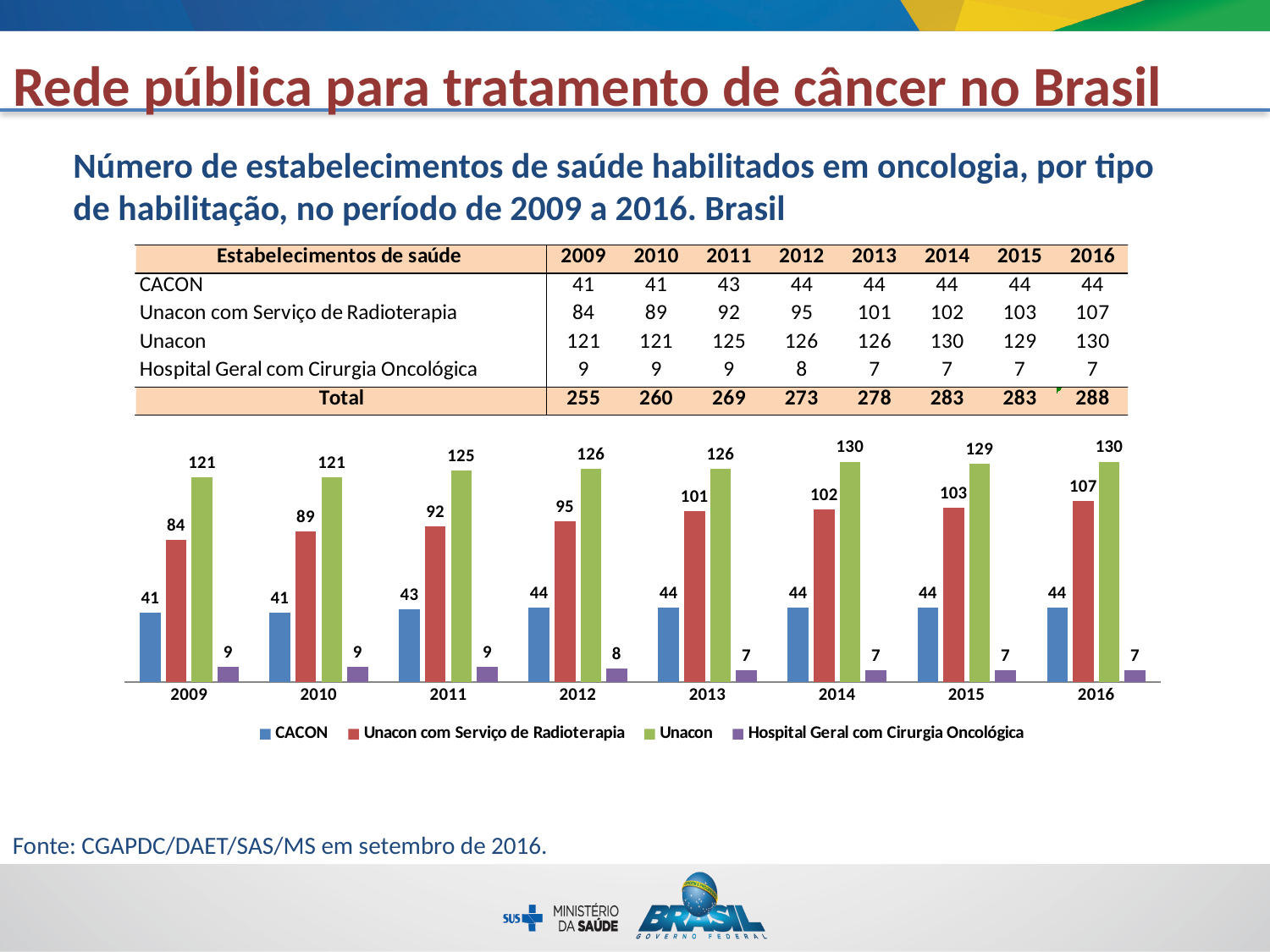
Which is larger: Unacon com Serviço de Radioterapia in 2010 or in 2012? 2012 How many years are shown on the x axis of the chart? 8 What is the value for Unacon com Serviço de Radioterapia in 2013? 101 How many series does the chart legend list? 4 Which series has the lowest value in 2014? Hospital Geral com Cirurgia Oncológica What is the difference between the Unacon value and the CACON value in 2009? 80 In which year is the value for Unacon com Serviço de Radioterapia highest? 2016 What kind of chart is shown on the slide? bar chart What is the value for Hospital Geral com Cirurgia Oncológica in 2012? 8 What is the value for CACON in 2011? 43 What is the value for Unacon in 2015? 129 Does the value for Unacon com Serviço de Radioterapia rise or fall from 2009 to 2016? rise